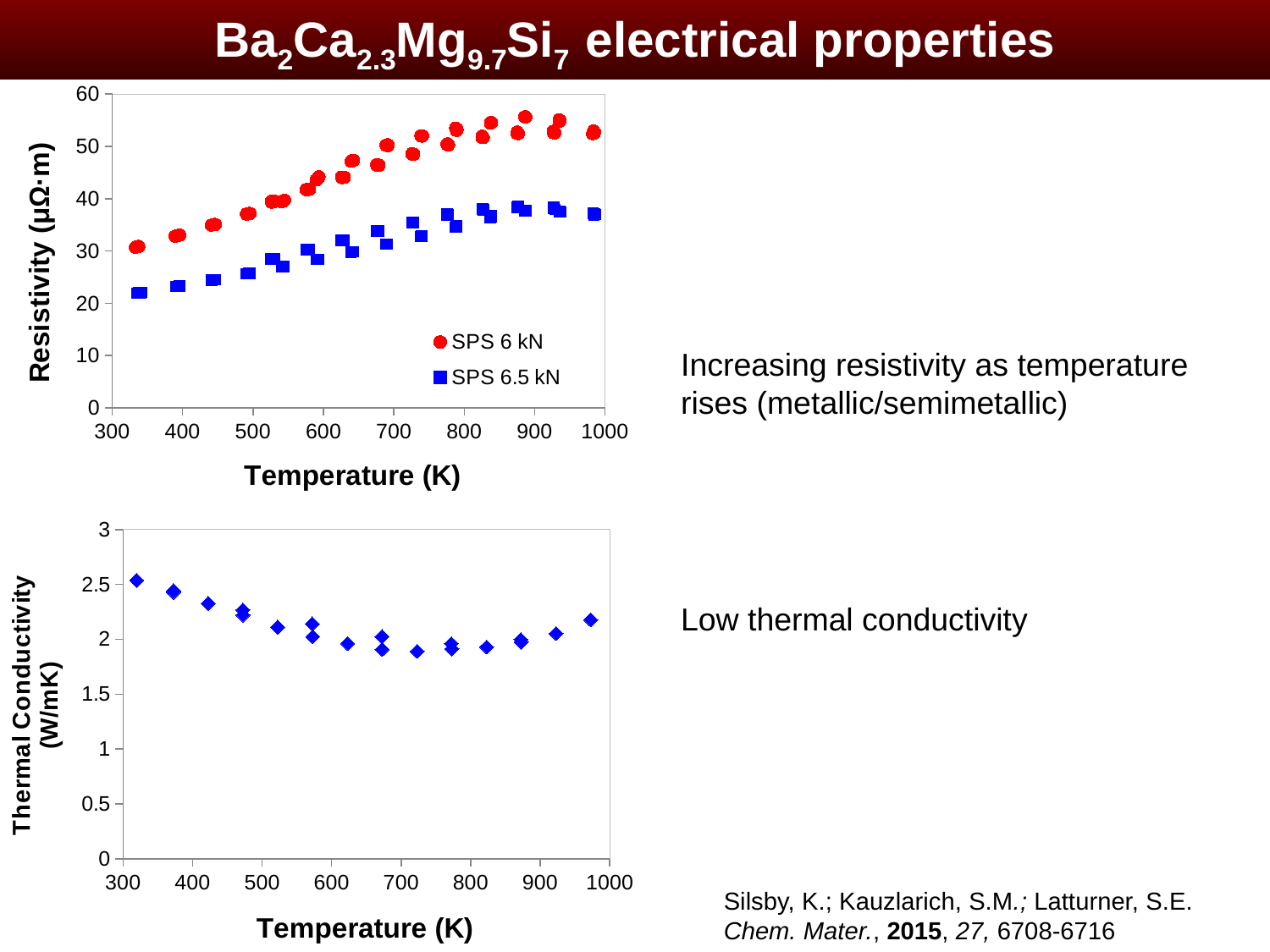
In the bottom chart (Thermal Conductivity vs Temperature), does the thermal conductivity rise or fall between 300 K and 700 K? fall In the top chart (Resistivity vs Temperature), is the resistivity of the SPS 6 kN series at about 900 K greater or less than 50? greater In the bottom chart (Thermal Conductivity vs Temperature), is the thermal conductivity at about 720 K greater or less than 2? less What kind of chart is the bottom chart (Thermal Conductivity vs Temperature)? scatter chart In the top chart (Resistivity vs Temperature), how many series does the legend list? 2 In the bottom chart (Thermal Conductivity vs Temperature), is the thermal conductivity at about 320 K greater or less than 2? greater In the top chart (Resistivity vs Temperature), which series has the higher resistivity across the temperature range, SPS 6 kN or SPS 6.5 kN? SPS 6 kN In the top chart (Resistivity vs Temperature), what are the two series named in the legend? SPS 6 kN and SPS 6.5 kN In the top chart (Resistivity vs Temperature), does the resistivity of the SPS 6 kN series generally rise or fall as temperature increases? rise In the top chart (Resistivity vs Temperature), what colour are the markers for the SPS 6.5 kN series? blue